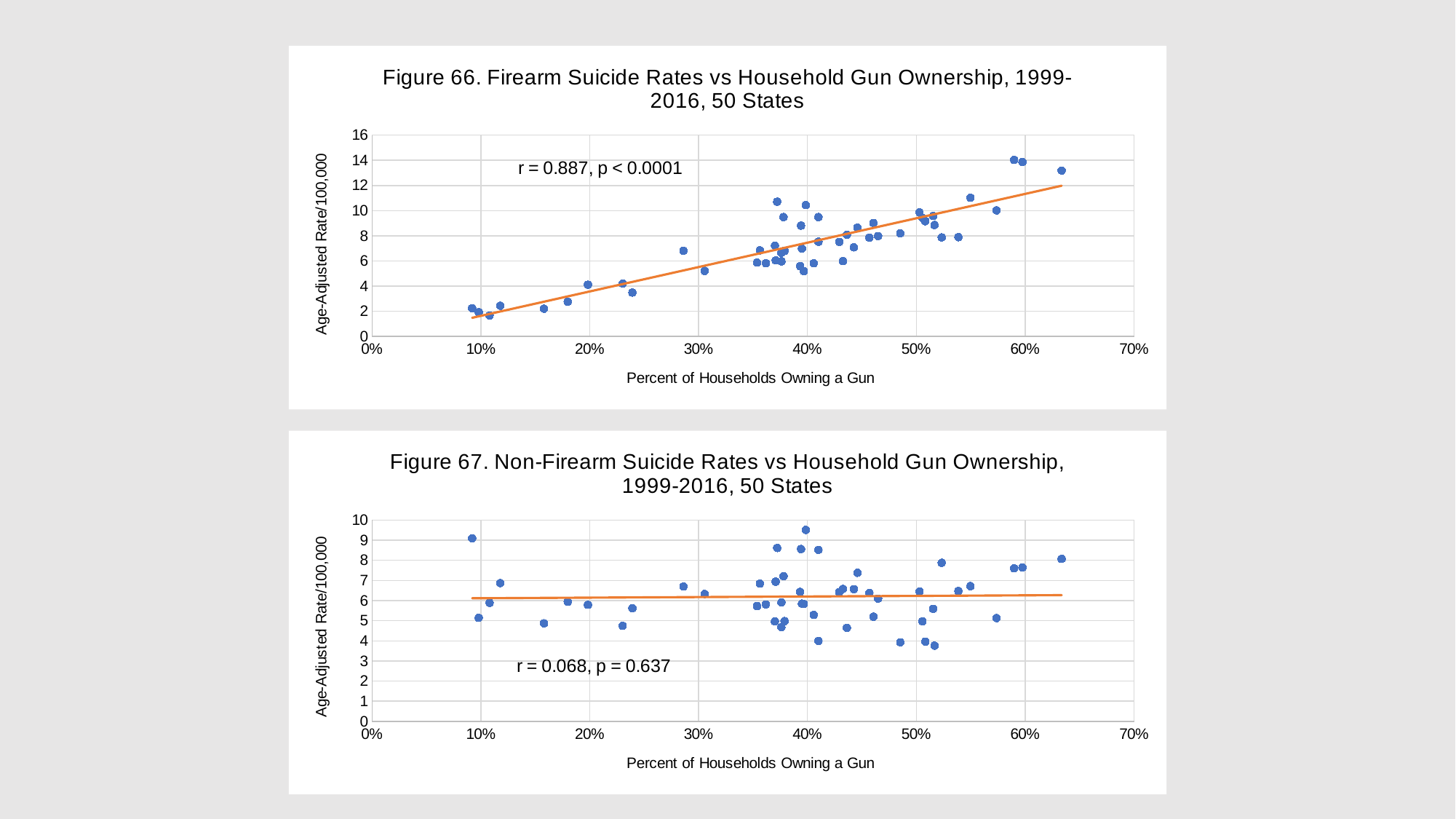
Which chart has the steeper trend line, Figure 66 or Figure 67? Figure 66 In Figure 67, is the lowest plotted non-firearm suicide rate greater or less than 5? less In Figure 66, is the lowest plotted firearm suicide rate greater or less than 4? less In Figure 67, do non-firearm suicide rates show a clear rise or fall as household gun ownership increases, or stay roughly flat? Roughly flat What kind of chart is Figure 67? Scatter plot In Figure 67, is the highest plotted non-firearm suicide rate greater or less than 8? greater What kind of chart is Figure 66? Scatter plot What is the maximum value shown on the x axis of Figure 66? 70% What correlation coefficient is printed on Figure 66? r = 0.887 What p-value is printed on Figure 67? p = 0.637 In Figure 66, do firearm suicide rates rise or fall as household gun ownership increases? Rise